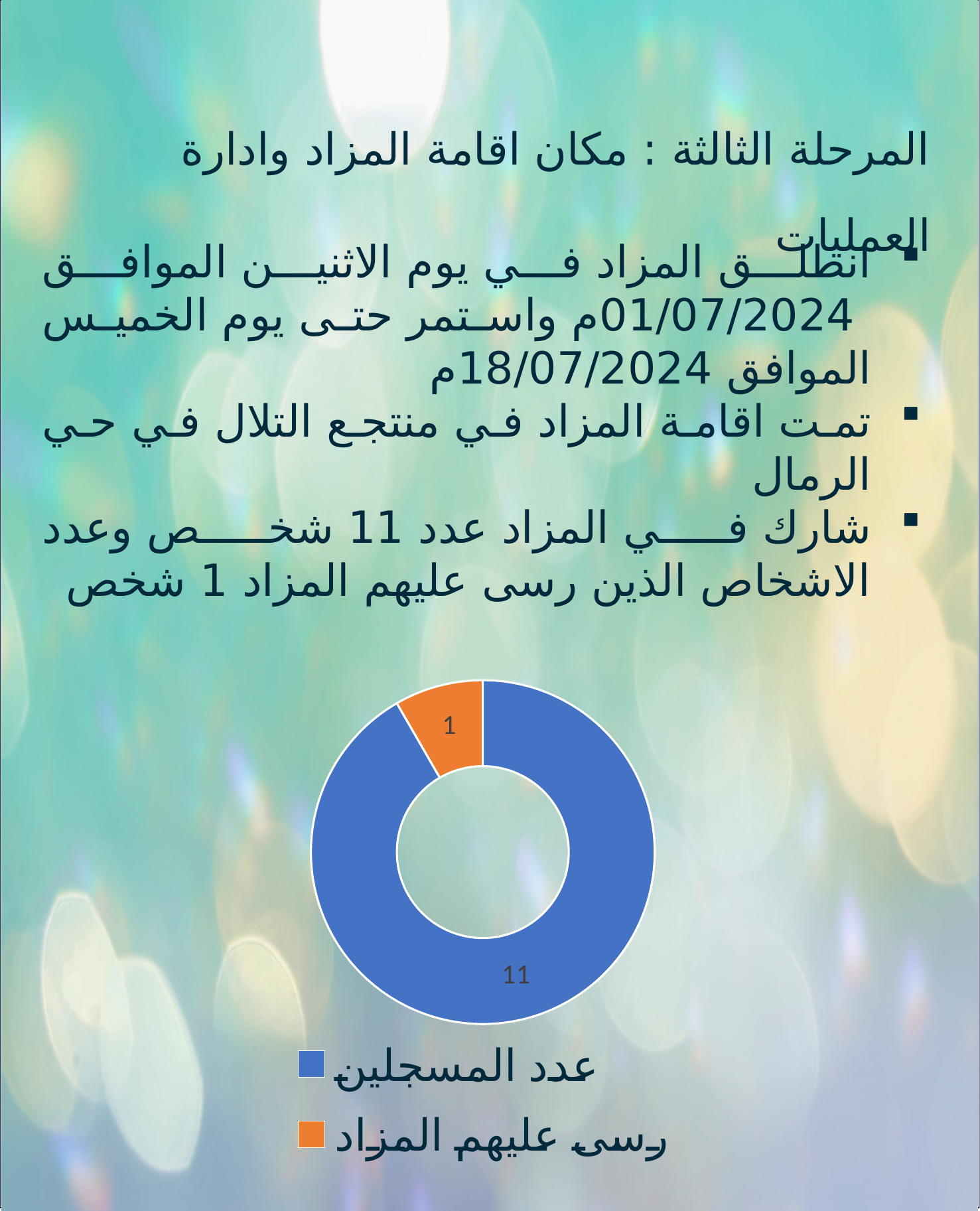
What is the total of all the values shown in the chart? 12 What fraction of the chart's total does رسى عليهم المزاد represent? 1/12 Which category has the largest slice in the chart? عدد المسجلين What is the value for عدد المسجلين in the chart? 11 What colour is the slice for رسى عليهم المزاد? orange How many entries does the chart legend list? 2 What type of chart is shown on the slide? doughnut chart Which is larger, the value for عدد المسجلين or the value for رسى عليهم المزاد? عدد المسجلين What is the difference between the values for عدد المسجلين and رسى عليهم المزاد? 10 Which category has the smallest slice in the chart? رسى عليهم المزاد How many slices does the chart have? 2 What is the value for رسى عليهم المزاد in the chart? 1